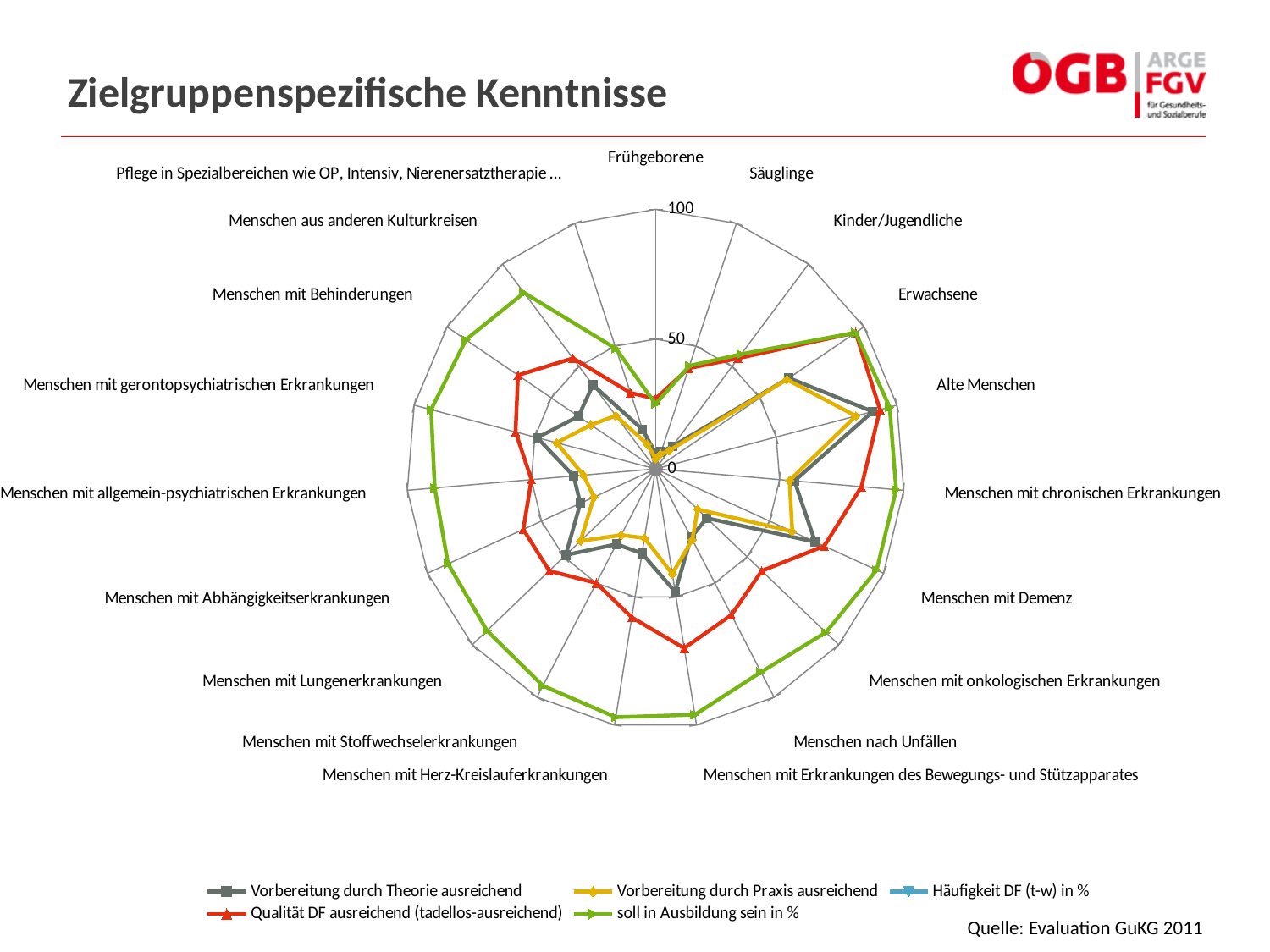
How many categories (axes) does the radar chart have? 19 Is the value of 'soll in Ausbildung sein in %' for Menschen mit chronischen Erkrankungen greater or less than 50? greater What kind of chart is shown on the slide? radar chart What is the title of the slide? Zielgruppenspezifische Kenntnisse What source is cited for the chart? Evaluation GuKG 2011 Is the value of 'Vorbereitung durch Praxis ausreichend' for Menschen mit Lungenerkrankungen greater or less than 50? less How many series does the legend list? 5 For Menschen mit Lungenerkrankungen, which series has the larger value: 'soll in Ausbildung sein in %' or 'Qualität DF ausreichend (tadellos-ausreichend)'? soll in Ausbildung sein in % Is the value of 'Vorbereitung durch Theorie ausreichend' for Erwachsene greater or less than 50? greater